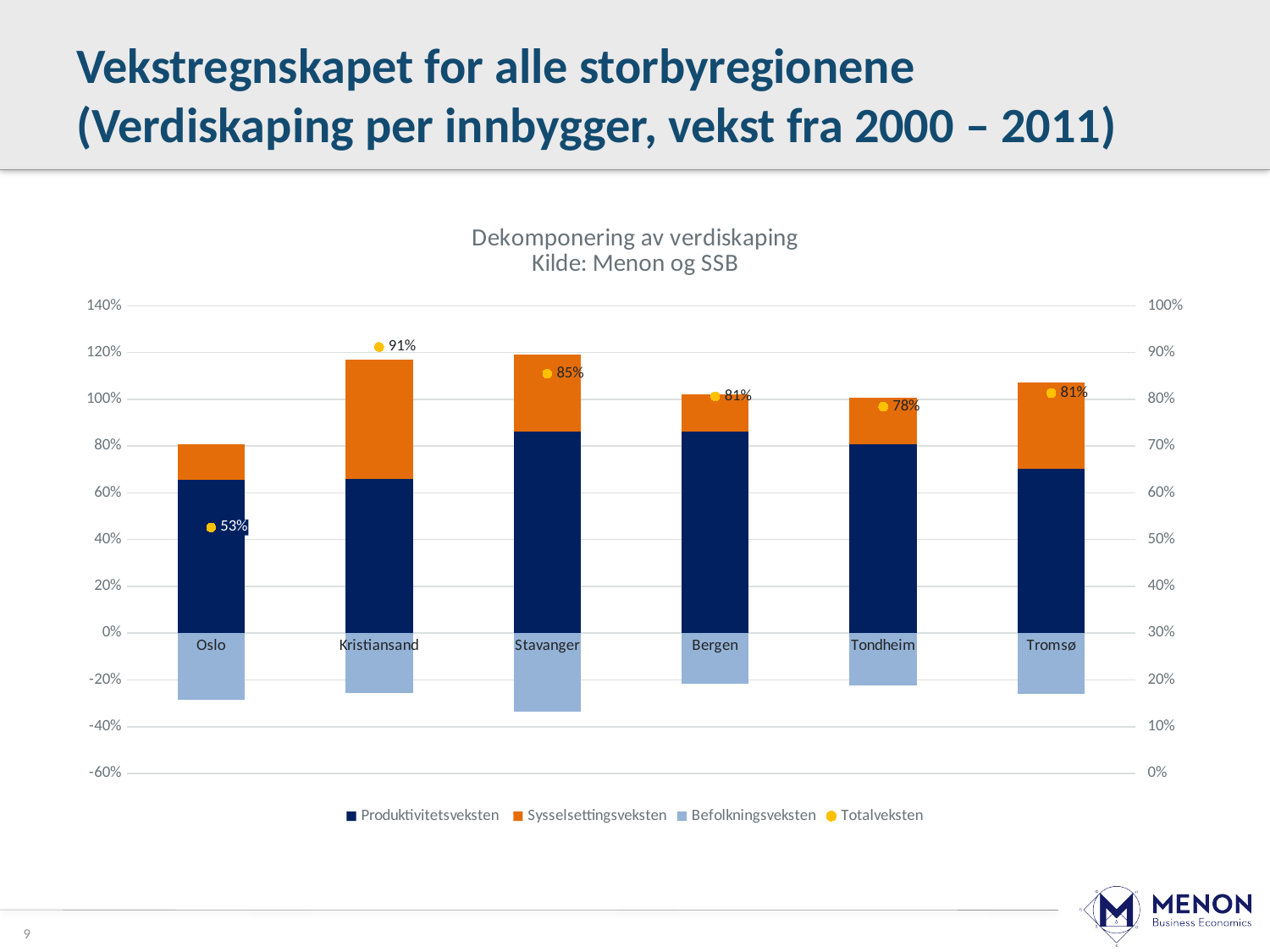
Is the Produktivitetsveksten value for Tromsø greater or less than 80%? less What is the Totalveksten value for Kristiansand? 91% Which series is shown in orange in the chart? Sysselsettingsveksten What is the difference between the Totalveksten values for Kristiansand and Oslo? 38 percentage points Which region has the lowest Totalveksten value? Oslo What is the Totalveksten value for Oslo? 53% Which has a higher Totalveksten value, Stavanger or Bergen? Stavanger How many series does the chart legend list? 4 What is the Totalveksten value for Tondheim? 78% Is the Produktivitetsveksten value for Stavanger greater or less than 80%? greater Which region has the highest Totalveksten value? Kristiansand How many regions are shown on the x axis of the chart? 6